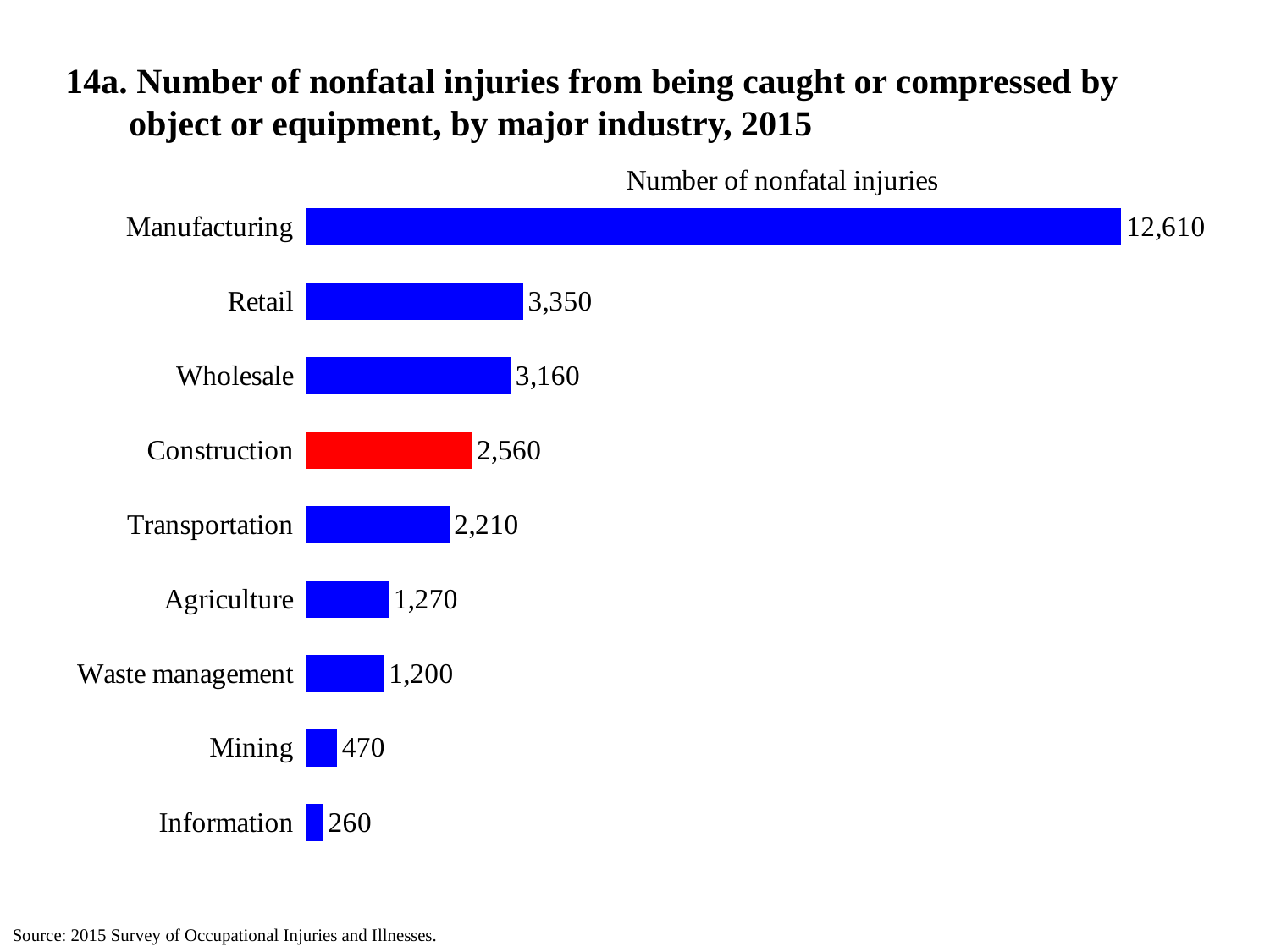
What is the difference in nonfatal injuries between Retail and Wholesale? 190 Which has more nonfatal injuries, Transportation or Agriculture? Transportation Which industry has the lowest number of nonfatal injuries? Information What is the number of nonfatal injuries for Manufacturing? 12,610 What is the number of nonfatal injuries for Construction? 2,560 How many industries are shown in the chart? 9 What kind of chart is shown on the slide? Bar chart What is the difference in nonfatal injuries between Manufacturing and Construction? 10,050 What is the number of nonfatal injuries for Waste management? 1,200 Which industry has the highest number of nonfatal injuries? Manufacturing Which industry's bar is coloured red? Construction Which has more nonfatal injuries, Mining or Information? Mining